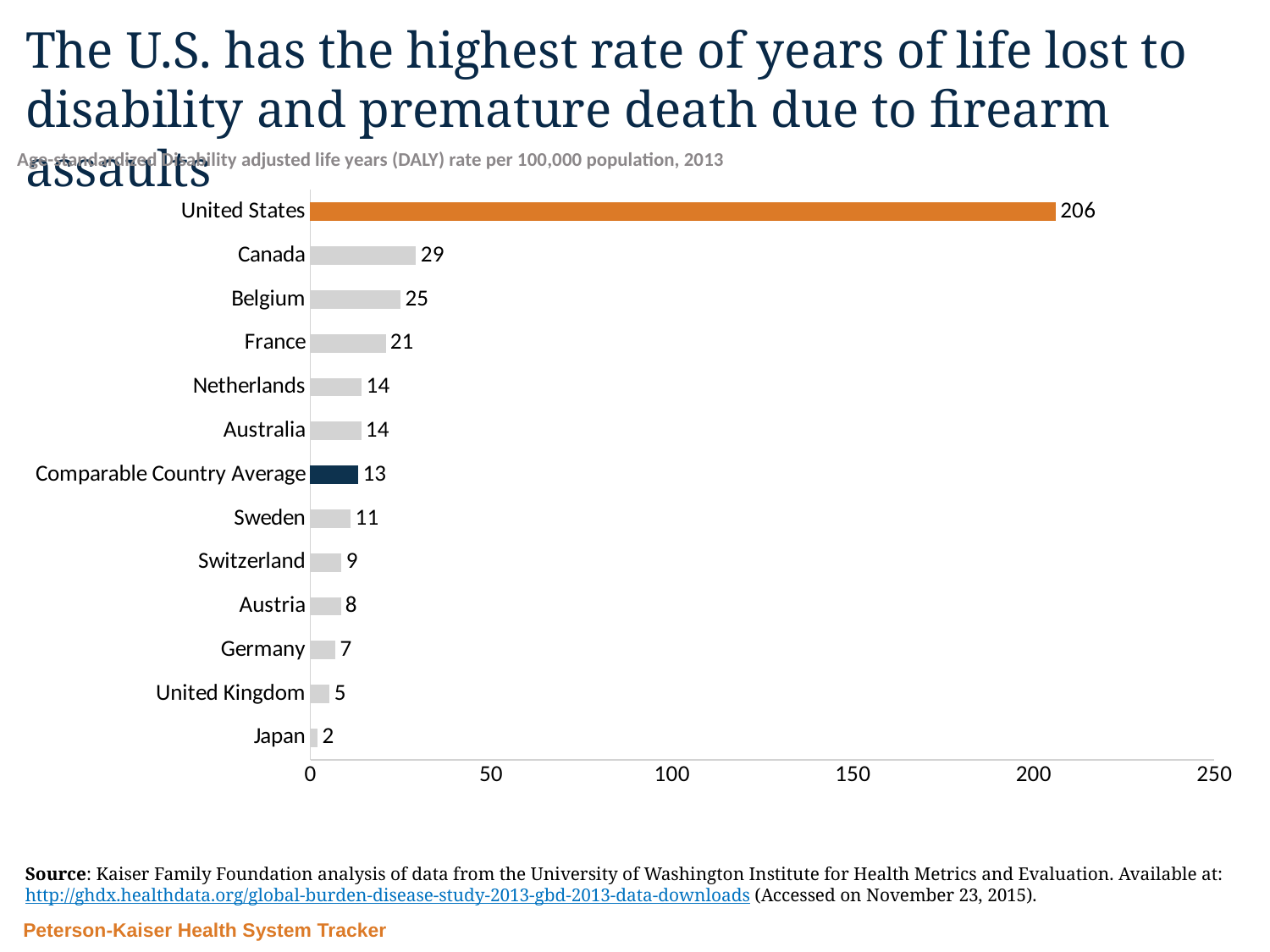
Which bar is coloured orange? United States How many categories are shown on the chart? 13 What is the value shown for Canada? 29 What is the difference between the values for Belgium and France? 4 What is the DALY rate for the United States? 206 What is the value for the Comparable Country Average? 13 Which has a larger value, Sweden or Switzerland? Sweden Which country has the lowest DALY rate on the chart? Japan Which category has the highest value on the chart? United States What is the difference between the values for the United States and Canada? 177 What kind of chart is shown on the slide? Bar chart Is the value for the United States greater or less than 200? greater